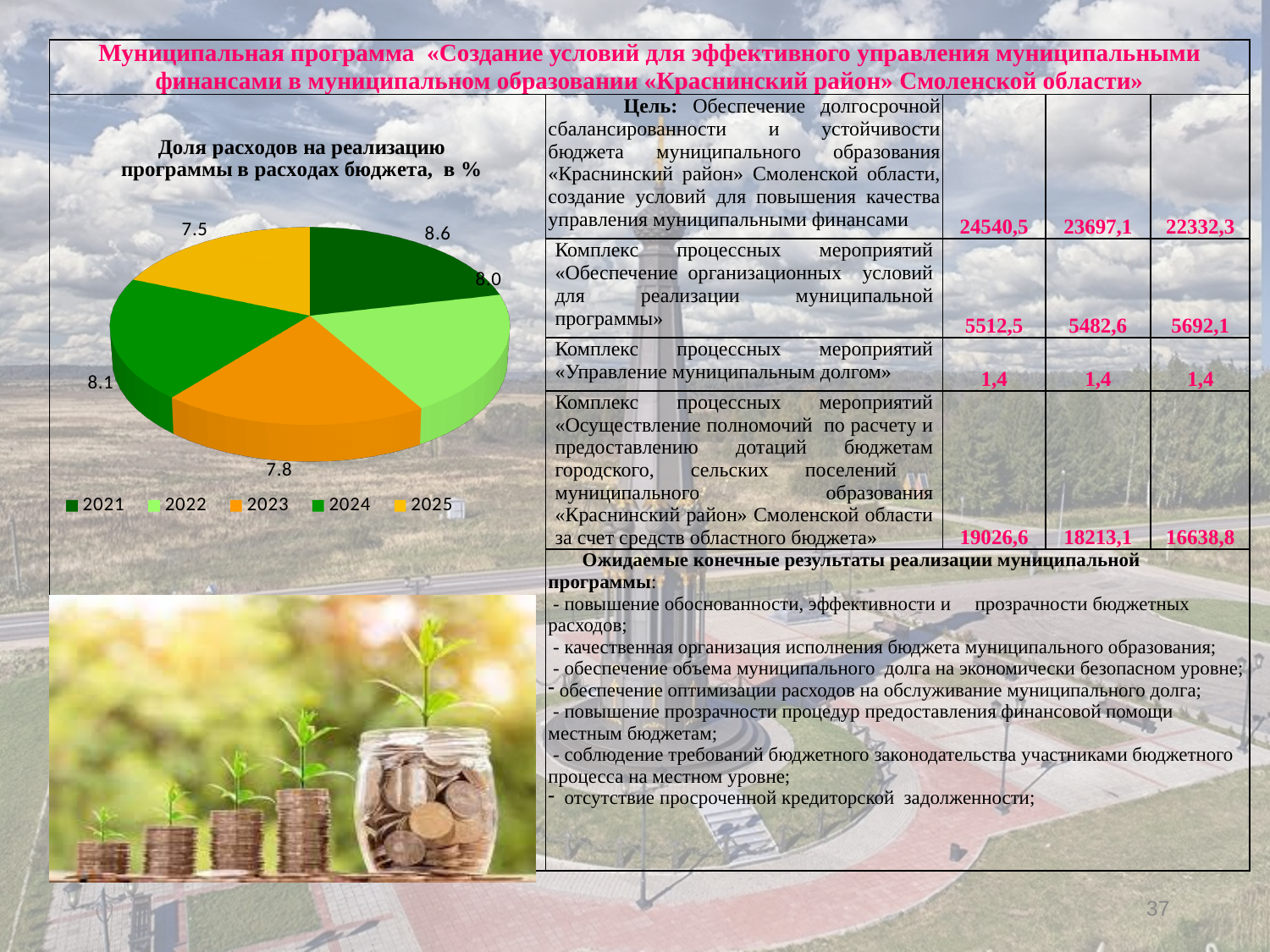
Which year has the lowest value in the pie chart? 2025 What is the title of the pie chart? Доля расходов на реализацию программы в расходах бюджета, в % What is the value for 2025 in the pie chart? 7.5 What is the value for 2024 in the pie chart? 8.1 What is the value for 2023 in the pie chart? 7.8 What type of chart is shown on the slide? pie chart Which year has the highest value in the pie chart? 2021 How many slices does the pie chart have? 5 What is the difference between the values for 2021 and 2025 in the pie chart? 1.1 What is the difference between the values for 2024 and 2023 in the pie chart? 0.3 Which is larger in the pie chart, the value for 2022 or the value for 2024? 2024 What is the value for 2021 in the pie chart? 8.6